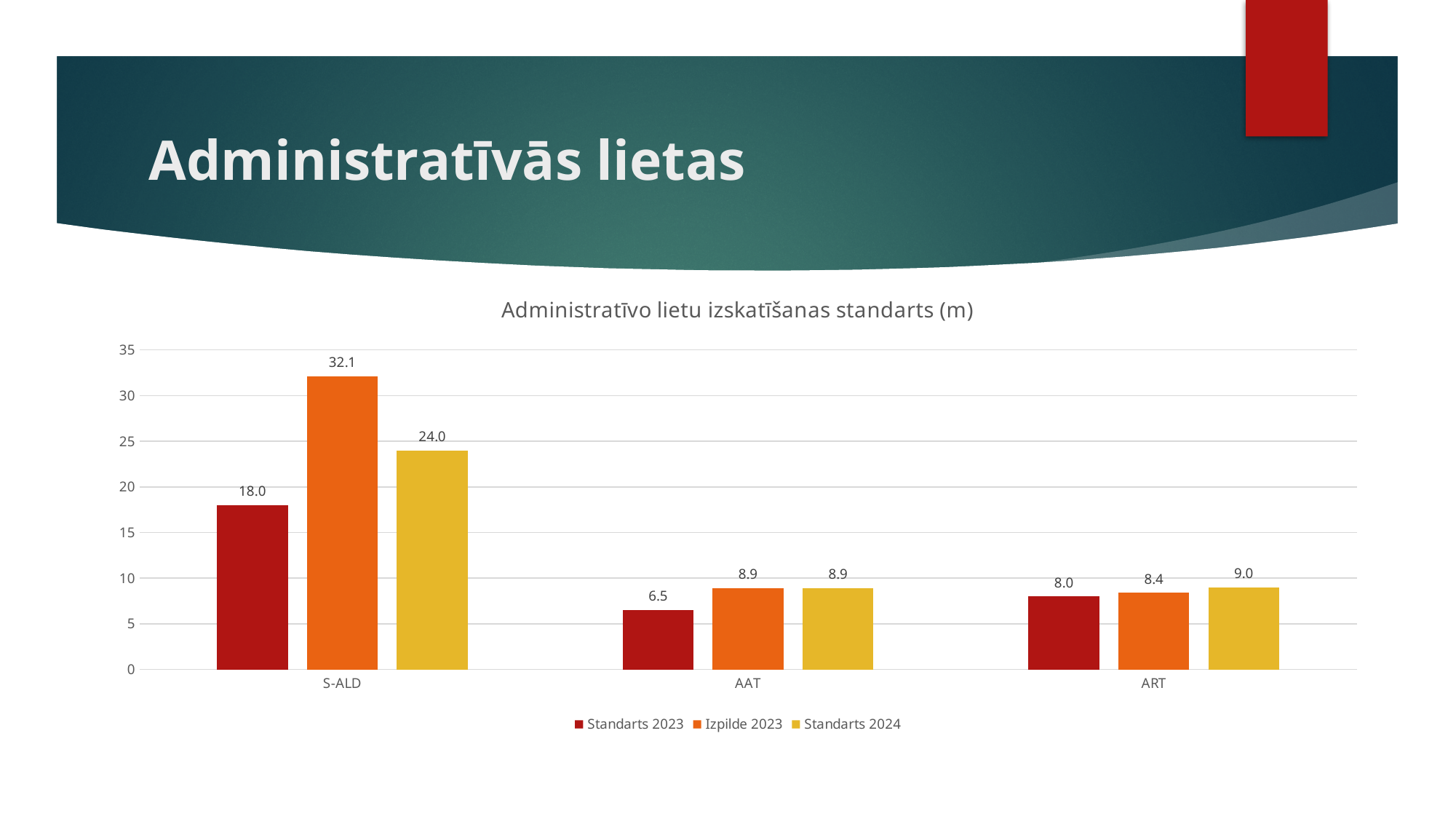
Which is larger for ART: Standarts 2023 or Standarts 2024? Standarts 2024 Is the value for Standarts 2024 for S-ALD greater or less than 20? greater What is the title of the chart? Administratīvo lietu izskatīšanas standarts (m) Which category has the lowest value for Standarts 2023? AAT How many series does the legend list? 3 How many categories are shown on the x axis? 3 What is the value for Izpilde 2023 for S-ALD? 32.1 What is the difference between Izpilde 2023 and Standarts 2023 for S-ALD? 14.1 What is the value for Standarts 2023 for AAT? 6.5 What is the value for Standarts 2024 for ART? 9.0 What kind of chart is shown on the slide? Bar chart Which category has the highest value for Izpilde 2023? S-ALD